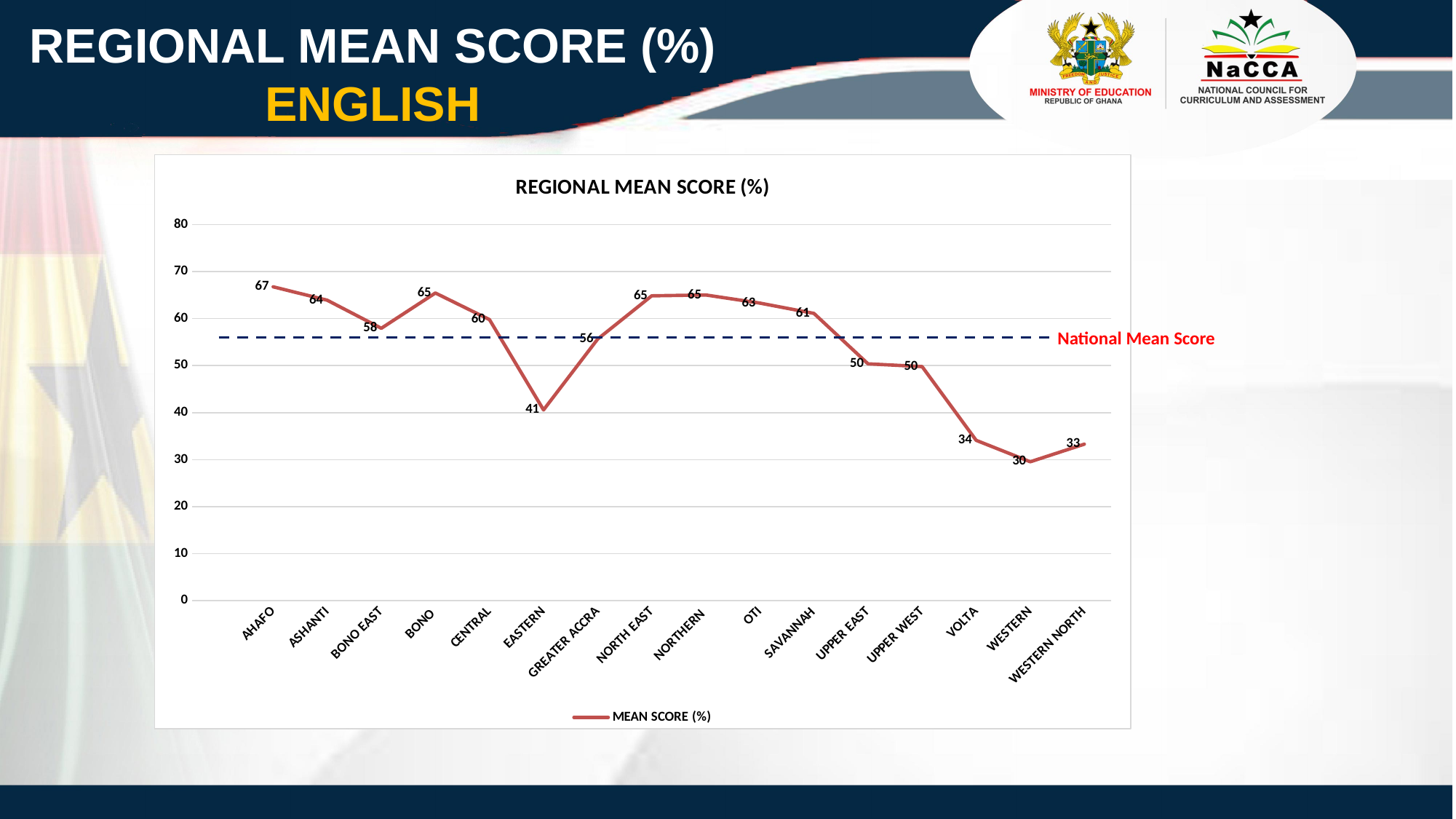
What is the mean score for AHAFO? 67 How many series does the legend list? 1 What is the difference between the mean scores of AHAFO and WESTERN? 37 What kind of chart is shown on the slide? line chart Which region has the highest mean score? AHAFO Is the mean score for UPPER EAST greater or less than 60? less Which has a higher mean score, VOLTA or WESTERN NORTH? VOLTA What does the dashed horizontal line on the chart represent? National Mean Score What is the mean score for EASTERN? 41 What is the mean score for GREATER ACCRA? 56 How many regions are plotted on the chart? 16 Which region has the lowest mean score? WESTERN